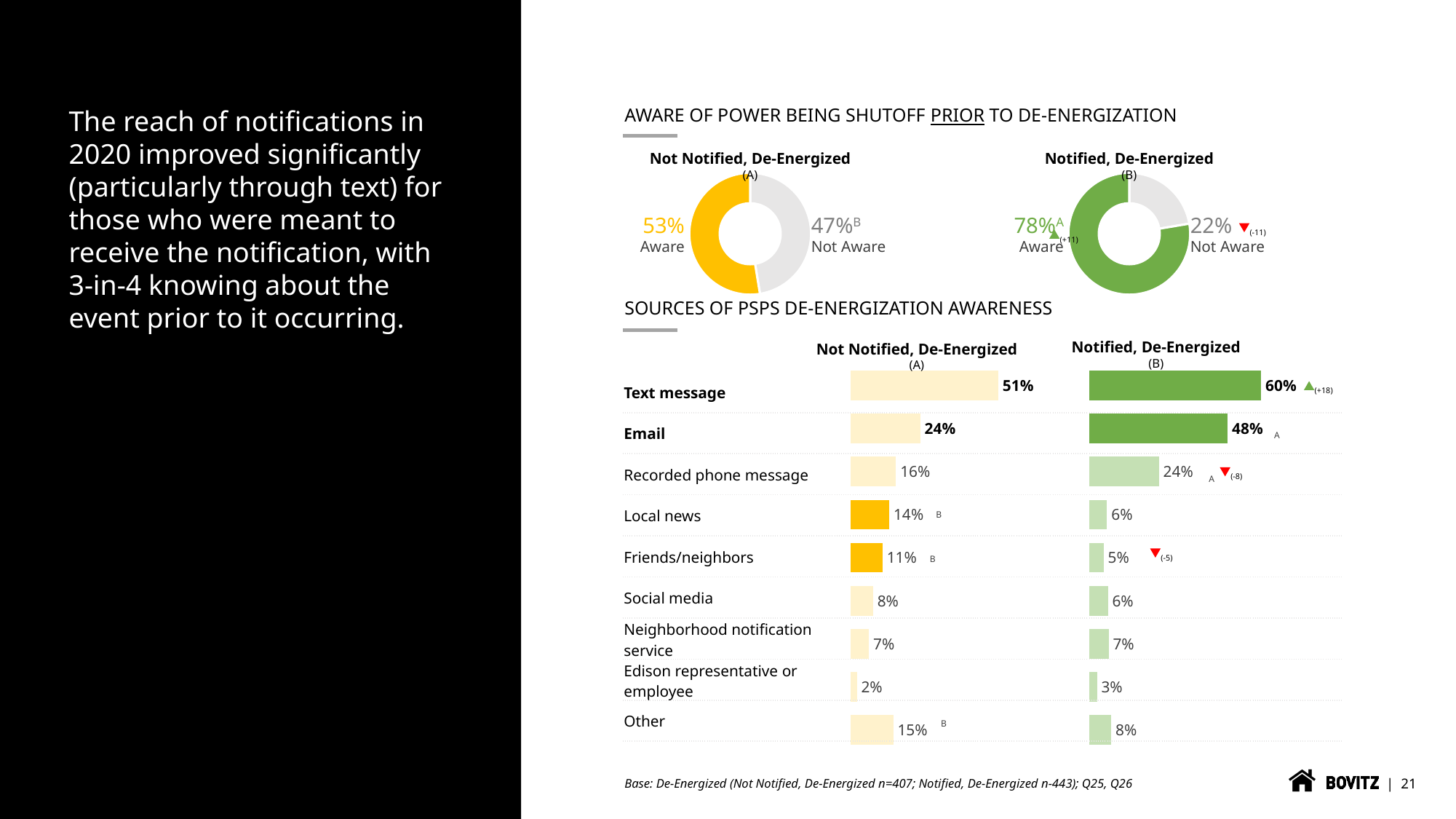
In the 'Sources of PSPS de-energization awareness' chart, what is the value for Other in the Notified, De-Energized group? 8% In the 'Sources of PSPS de-energization awareness' chart, which group has the larger value for Local news: Not Notified, De-Energized or Notified, De-Energized? Not Notified, De-Energized What type of chart is used for 'Sources of PSPS de-energization awareness'? Bar chart In the 'Not Notified, De-Energized' donut chart under 'Aware of power being shutoff prior to de-energization', what percentage were Aware? 53% In the 'Sources of PSPS de-energization awareness' chart, what is the value for Text message in the Notified, De-Energized group? 60% In the 'Sources of PSPS de-energization awareness' chart, which source has the lowest value for the Notified, De-Energized group? Edison representative or employee What type of chart is used to show awareness of power being shutoff prior to de-energization? Donut (pie) chart In the 'Sources of PSPS de-energization awareness' chart, what is the difference between the Notified and Not Notified values for Email? 24% In the 'Sources of PSPS de-energization awareness' chart, which source has the highest value for the Not Notified, De-Energized group? Text message How many sources are listed in the 'Sources of PSPS de-energization awareness' chart? 9 In the 'Sources of PSPS de-energization awareness' chart, what is the value for Email in the Not Notified, De-Energized group? 24% In the 'Notified, De-Energized' donut chart under 'Aware of power being shutoff prior to de-energization', what percentage were Not Aware? 22%